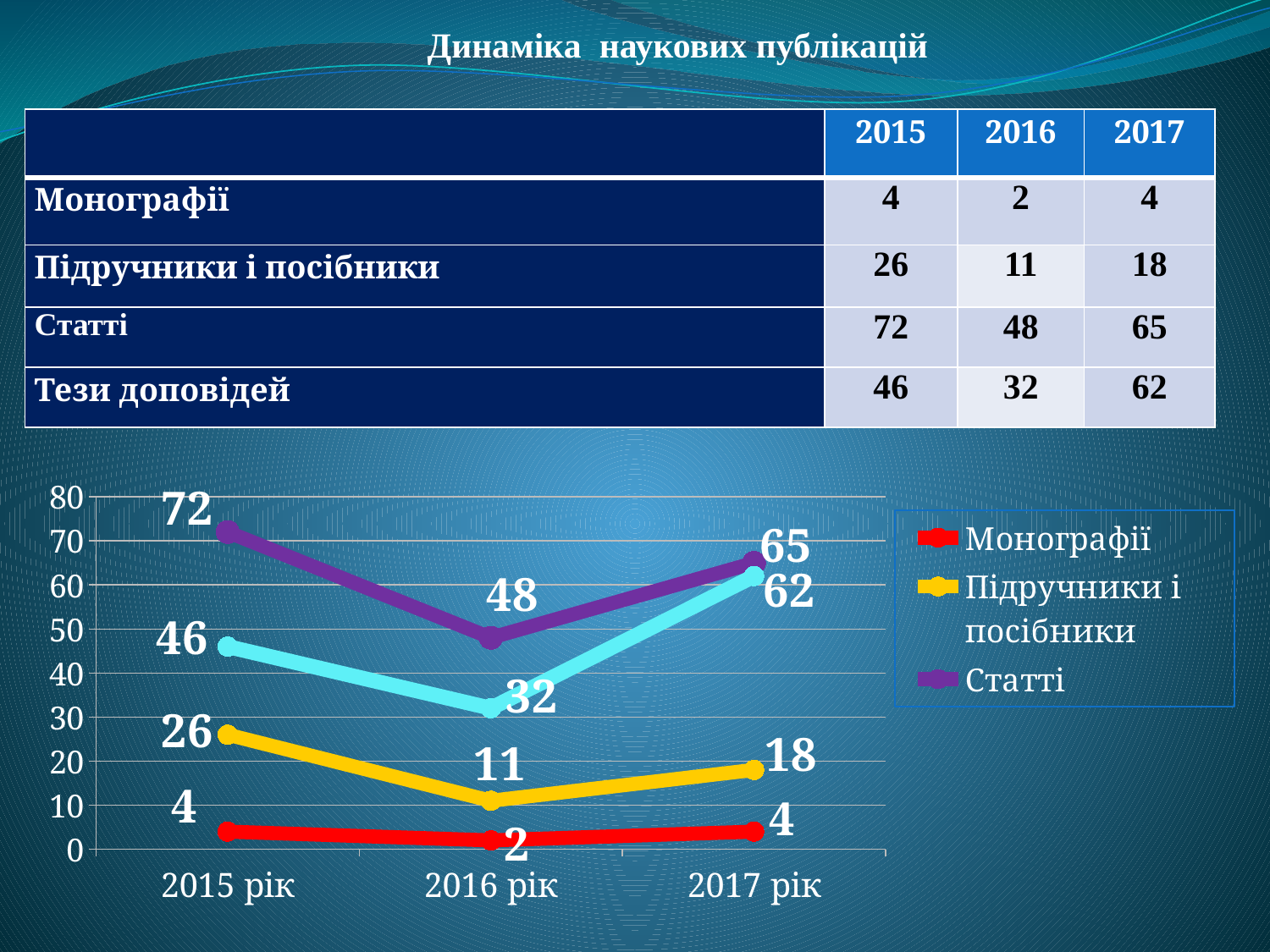
What is the value for Статті in 2016 рік? 48 What colour is the Монографії line in the chart? red In which year is the value for Статті highest? 2015 рік How many series does the chart legend list? 3 What is the value for Монографії in 2016 рік? 2 Which is larger in 2017 рік: the value for Статті or the value for Підручники і посібники? Статті How many points along the x axis does the chart have? 3 What kind of chart is shown on the slide? line chart What is the value for Підручники і посібники in 2017 рік? 18 In which year is the value for Підручники і посібники lowest? 2016 рік What is the difference between the Статті values for 2015 рік and 2016 рік? 24 Does the Підручники і посібники line rise or fall from 2015 рік to 2016 рік? fall